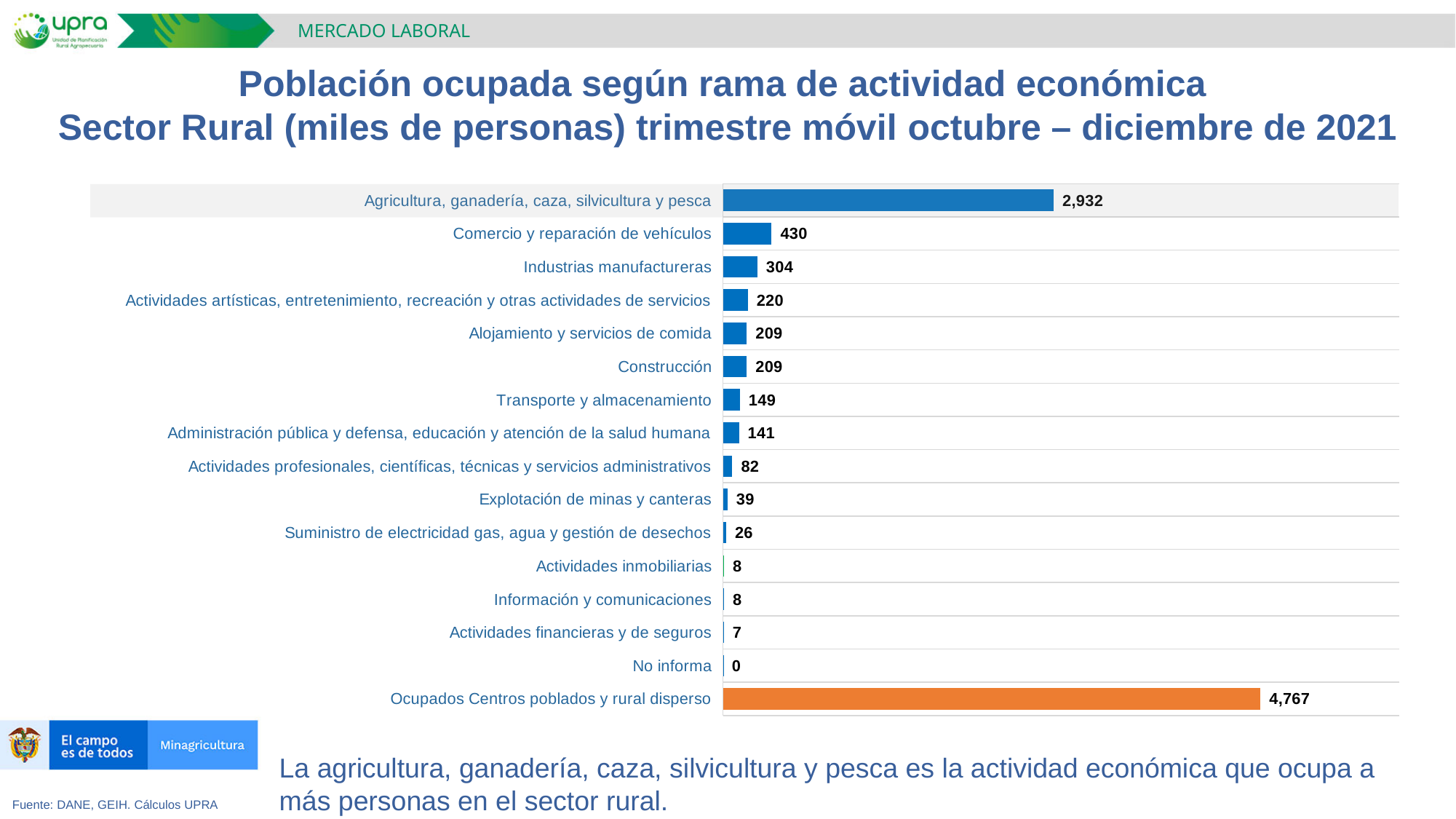
What is the value for Ocupados Centros poblados y rural disperso? 4,767 Which category has the lowest value in the chart? No informa Which category has the longest bar in the chart? Ocupados Centros poblados y rural disperso How many bars are plotted in the chart? 16 What kind of chart is shown on the slide? Bar chart What is the value for Agricultura, ganadería, caza, silvicultura y pesca? 2,932 What is the value for Explotación de minas y canteras? 39 What is the difference between the values for Comercio y reparación de vehículos and Industrias manufactureras? 126 What is the difference between the values for Agricultura, ganadería, caza, silvicultura y pesca and Comercio y reparación de vehículos? 2,502 Which is larger, the value for Industrias manufactureras or the value for Actividades artísticas, entretenimiento, recreación y otras actividades de servicios? Industrias manufactureras What is the value for Comercio y reparación de vehículos? 430 What colour is the bar for Ocupados Centros poblados y rural disperso? Orange